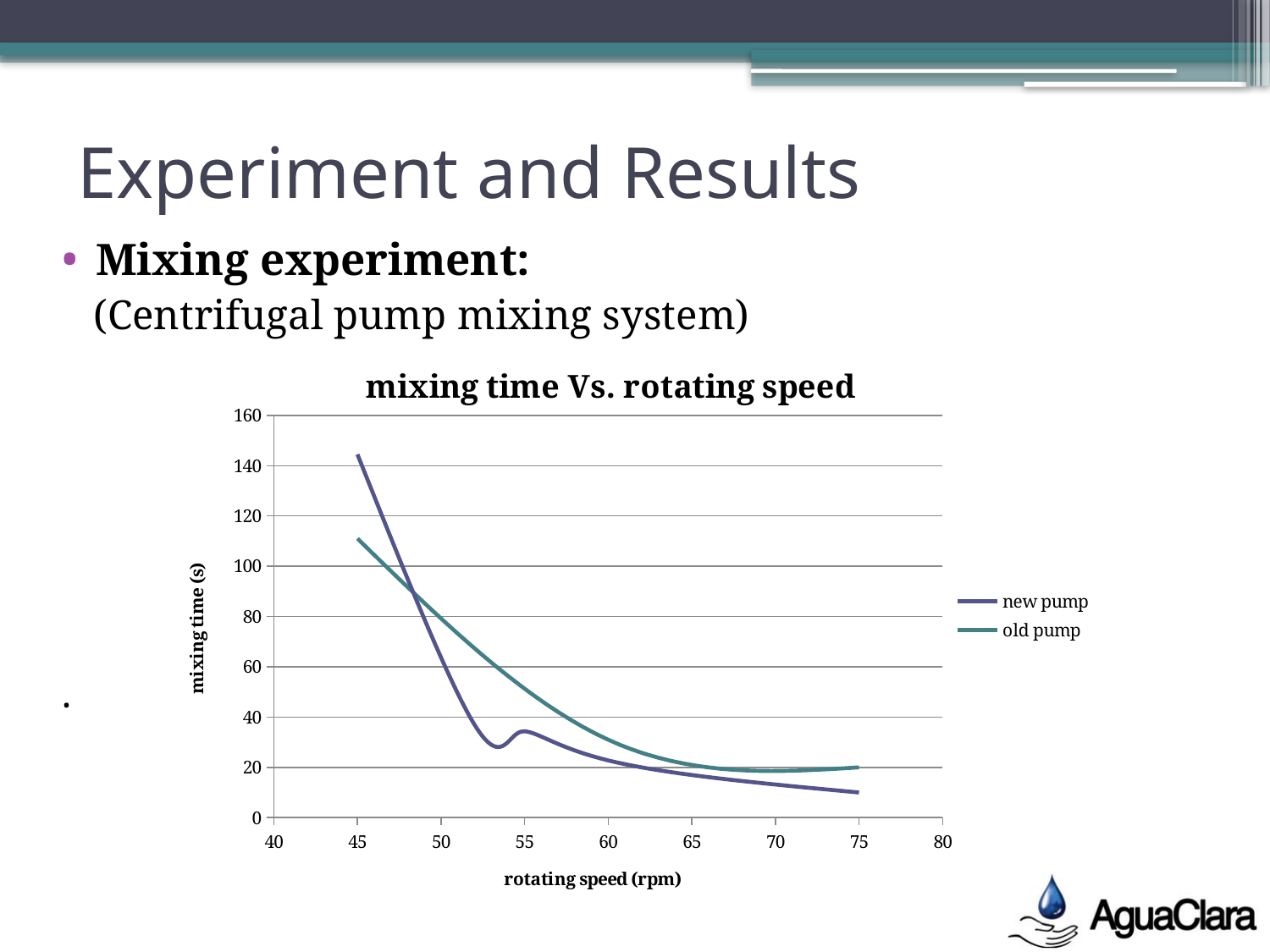
What is the label of the x axis? rotating speed (rpm) Is the mixing time for the old pump at 45 rpm greater or less than 100? greater Does the mixing time for the old pump rise or fall as rotating speed increases from 45 to 65 rpm? fall What is the title of the chart? mixing time Vs. rotating speed At 55 rpm, which series has the higher mixing time, new pump or old pump? old pump Is the mixing time for the new pump at 45 rpm greater or less than 120? greater Does the mixing time for the new pump rise or fall as rotating speed increases from 45 to 75 rpm? fall At 45 rpm, which series has the higher mixing time, new pump or old pump? new pump How many series does the legend list? 2 What kind of chart is shown on the slide? line chart Is the mixing time for the old pump at 55 rpm greater or less than 40? greater